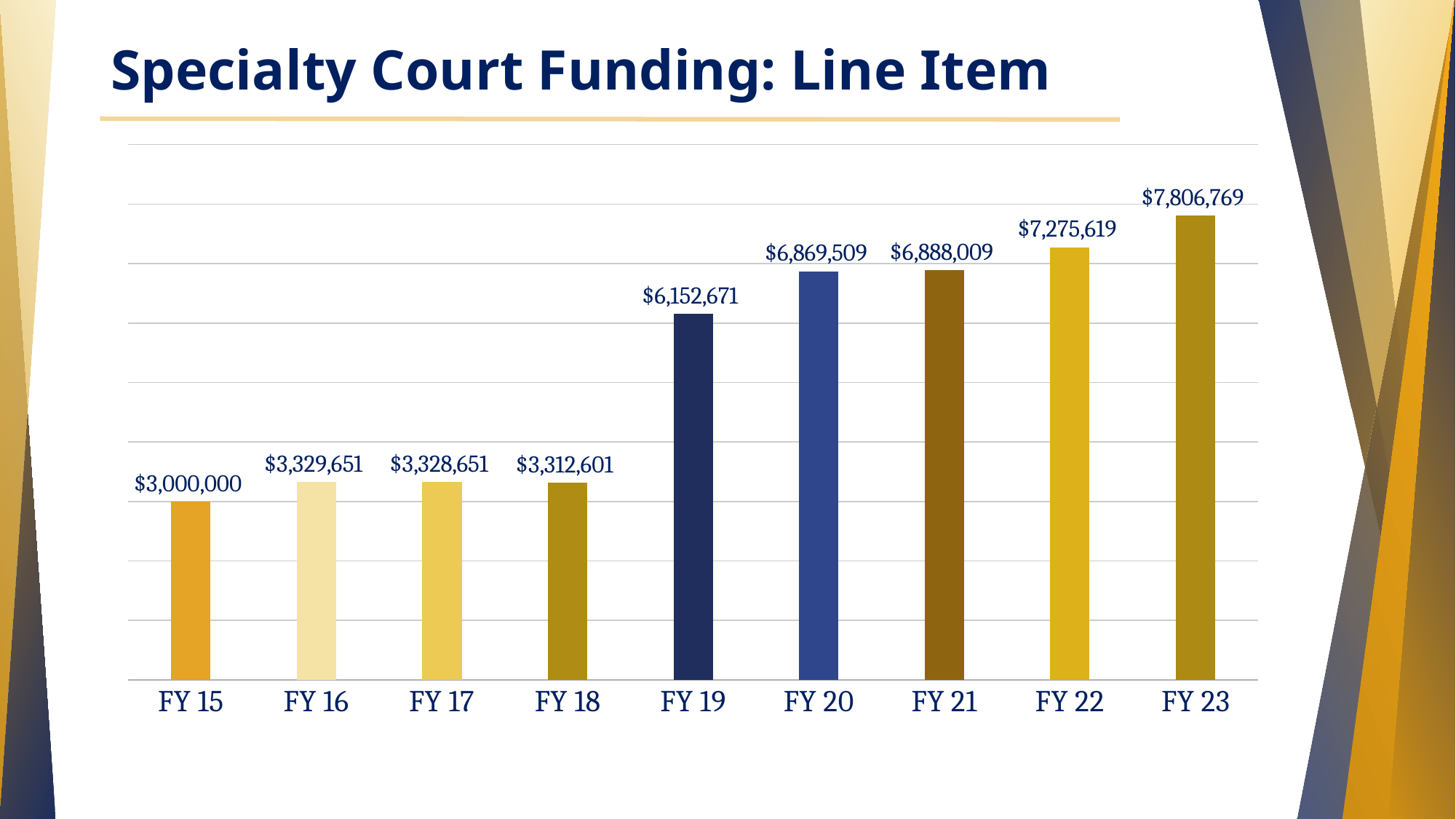
Which fiscal year has the lowest funding? FY 15 What is the value for FY 22? $7,275,619 What is the difference between the FY 19 and FY 18 values? $2,840,070 Which fiscal year has the highest funding? FY 23 What is the value for FY 19? $6,152,671 What kind of chart is shown on the slide? Bar chart What is the value for FY 15? $3,000,000 What is the title of the slide? Specialty Court Funding: Line Item What is the difference between the FY 23 and FY 22 values? $531,150 Which is larger, the value for FY 20 or the value for FY 18? FY 20 Which is larger, the value for FY 16 or the value for FY 17? FY 16 How many fiscal years are shown on the chart? 9